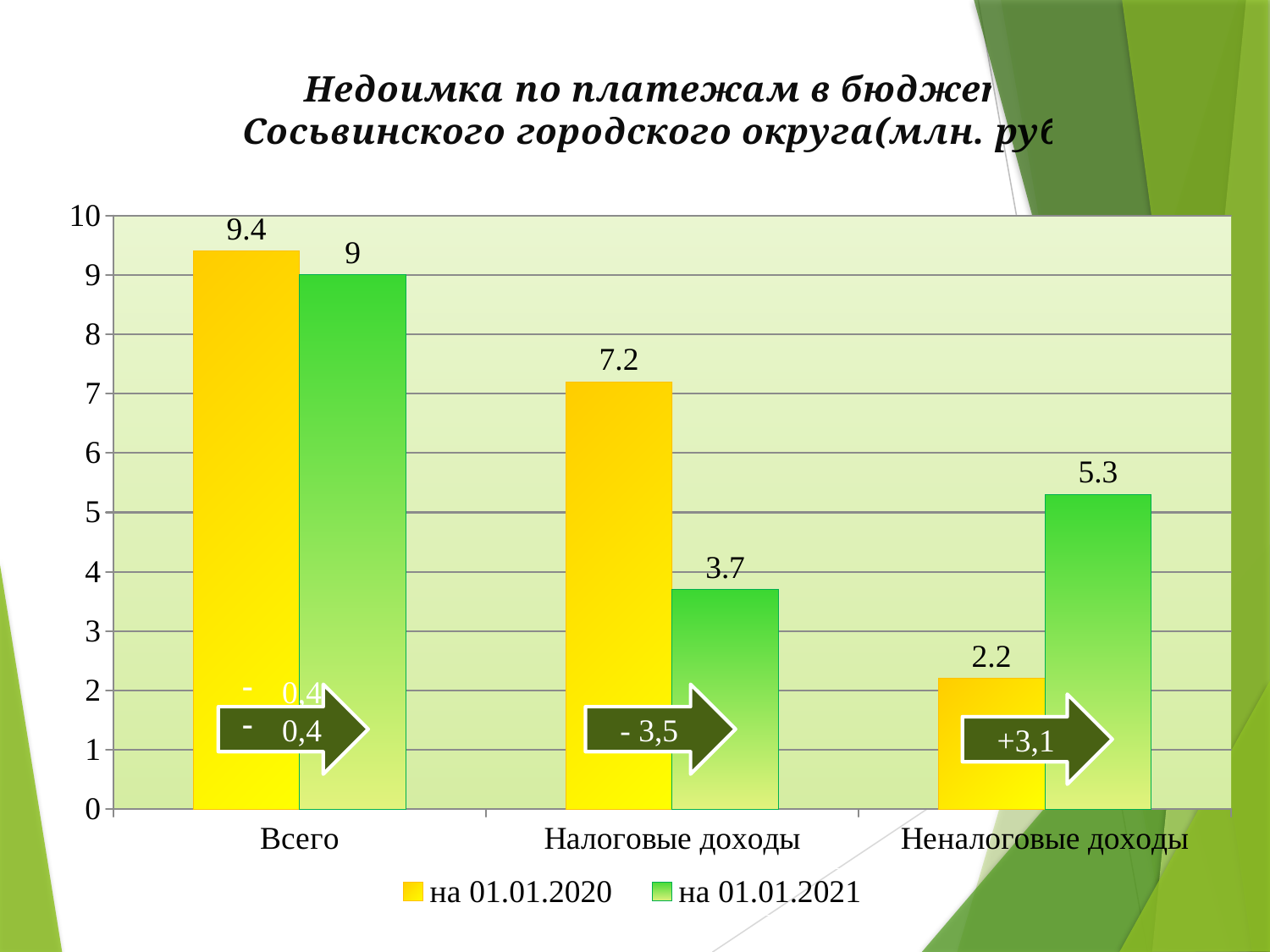
What is the value for Всего in the series на 01.01.2020? 9.4 What kind of chart is shown on the slide? Bar chart What is the difference between the на 01.01.2020 and на 01.01.2021 values for Налоговые доходы? 3.5 Which category has the highest value in the series на 01.01.2021? Всего What is the value for Неналоговые доходы in the series на 01.01.2021? 5.3 What colour are the bars for the series на 01.01.2020? Yellow How many series does the legend list? 2 How many categories are shown on the x axis? 3 For Неналоговые доходы, which series has the larger value: на 01.01.2020 or на 01.01.2021? на 01.01.2021 What is the value for Налоговые доходы in the series на 01.01.2021? 3.7 What is the value for Неналоговые доходы in the series на 01.01.2020? 2.2 Which category has the lowest value in the series на 01.01.2020? Неналоговые доходы